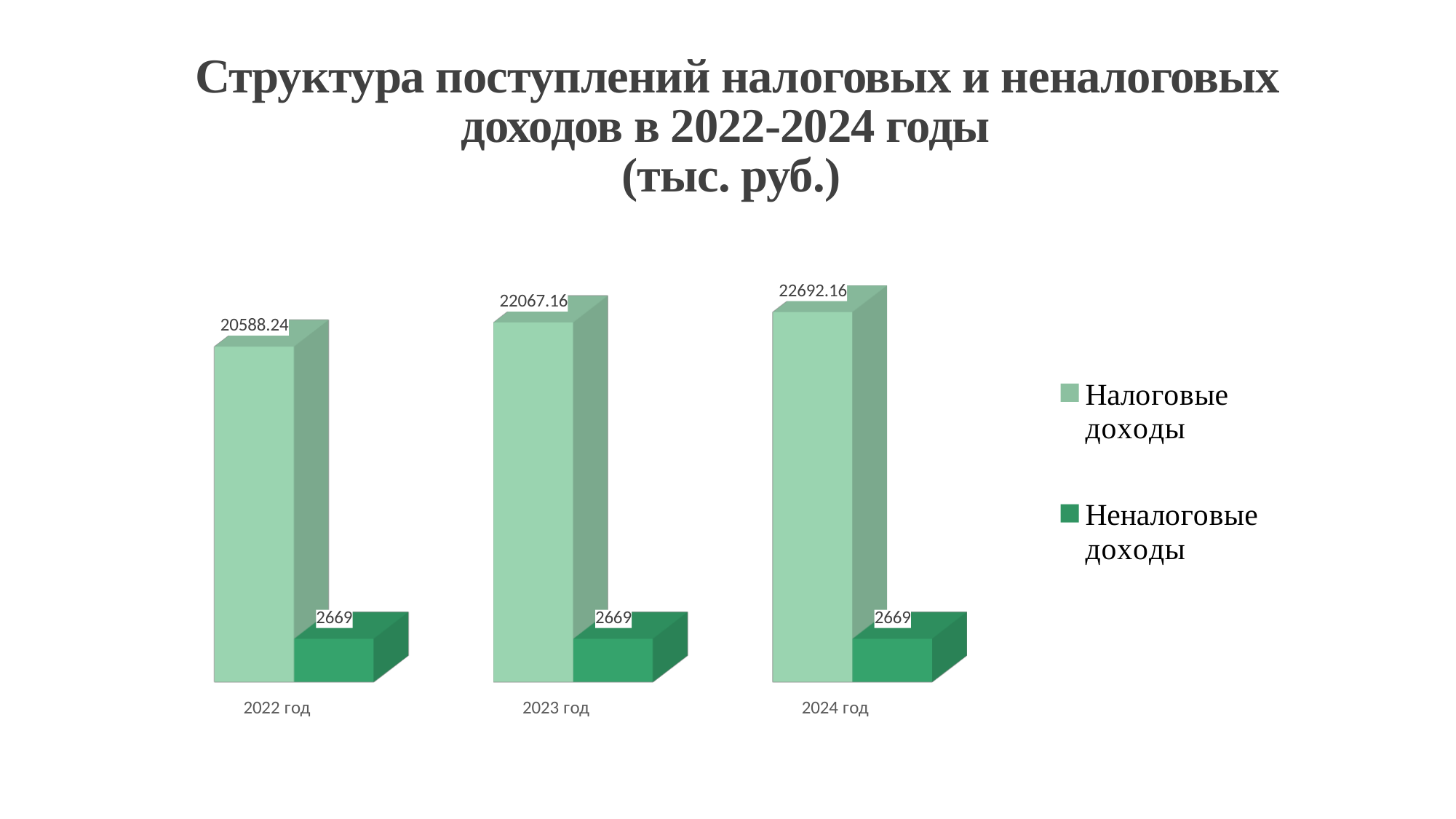
What is the value of Неналоговые доходы for 2023 год? 2669 What is the value of Налоговые доходы for 2024 год? 22692.16 In which year is Налоговые доходы lowest? 2022 год What is the value of Налоговые доходы for 2022 год? 20588.24 What is the value of Налоговые доходы for 2023 год? 22067.16 How many years are shown on the x axis? 3 In which year is Налоговые доходы highest? 2024 год What is the difference between Налоговые доходы in 2024 год and 2022 год? 2103.92 Does Налоговые доходы rise or fall from 2022 год to 2024 год? rise What is the difference between Налоговые доходы in 2023 год and 2022 год? 1478.92 Which is larger in 2023 год: Налоговые доходы or Неналоговые доходы? Налоговые доходы How many series does the legend list? 2